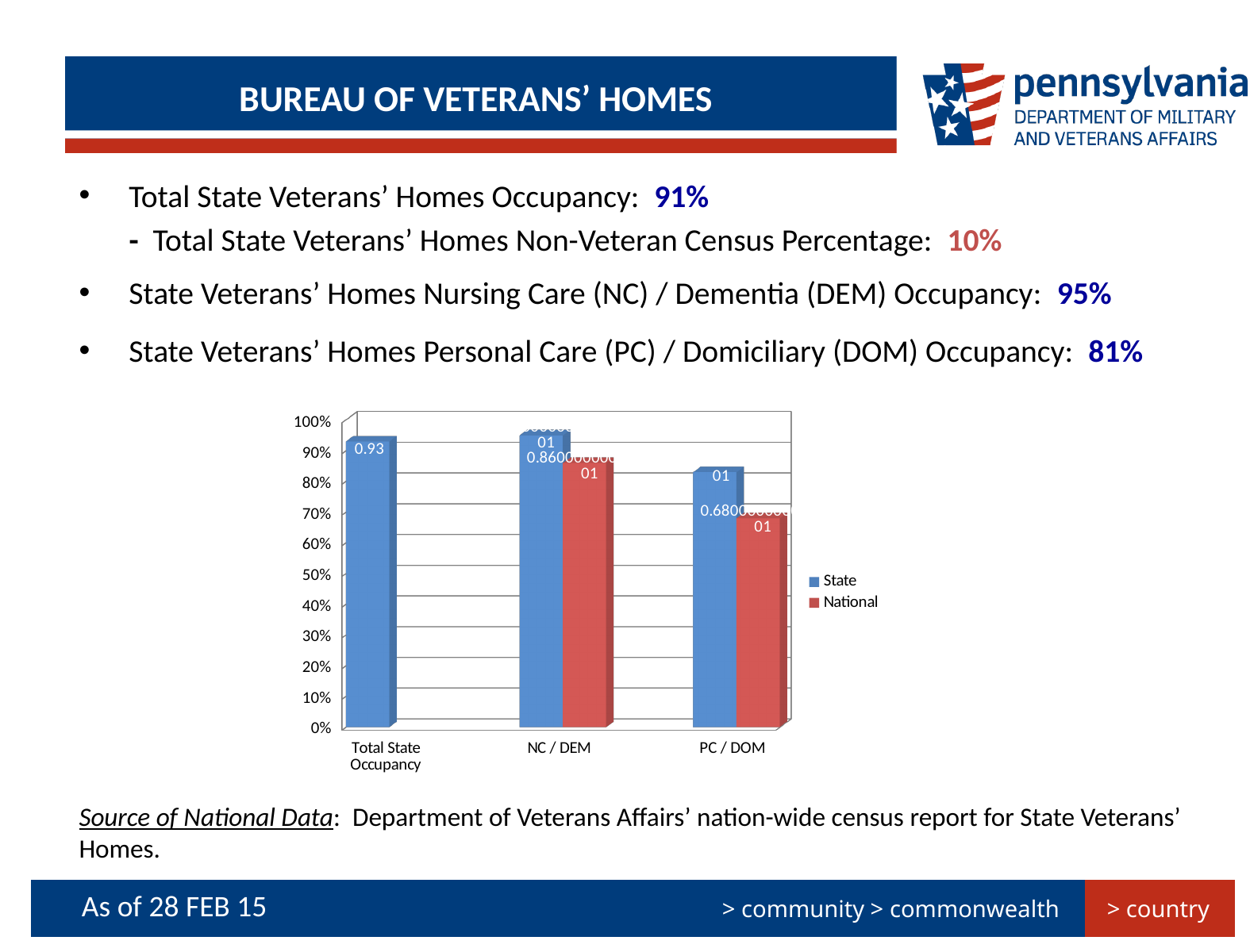
What kind of chart is shown on the slide? bar chart For PC / DOM, which is larger, the State bar or the National bar? State What is the State value for Total State Occupancy in the chart? 0.93 Which category has the highest State bar in the chart? NC / DEM Is the National value for NC / DEM greater or less than 80%? greater Is the State value for NC / DEM greater or less than 90%? greater How many series does the chart legend list? 2 Is the National value for PC / DOM greater or less than 60%? greater Which category has the lowest National bar in the chart? PC / DOM For NC / DEM, which is larger, the State bar or the National bar? State How many categories are shown on the x axis of the chart? 3 Which colour represents the National series in the chart? red